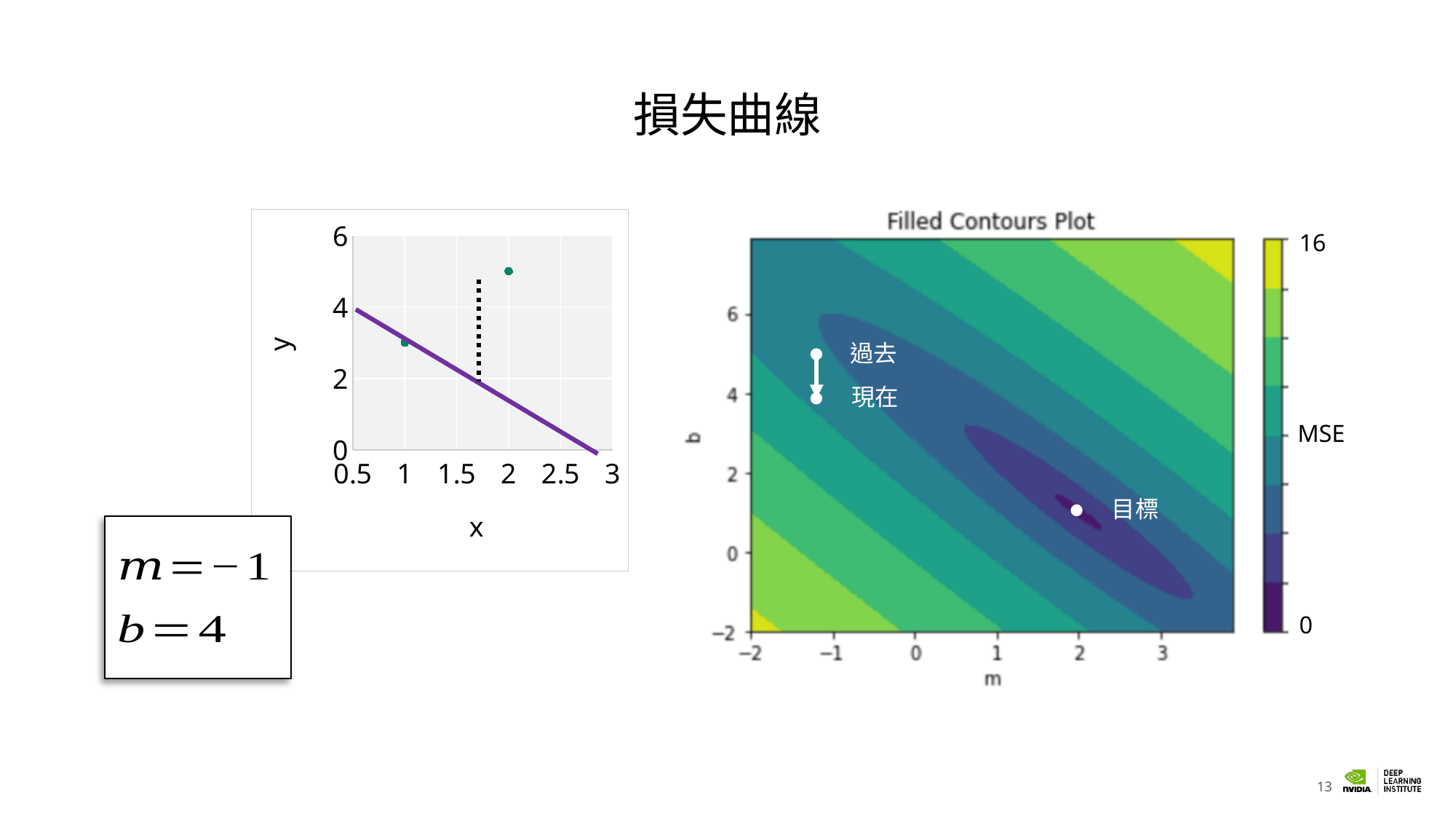
On the right chart, is the b value of the point labelled 過去 greater or less than 4? greater On the left chart, does the purple line rise or fall as x increases? fall On the right chart, what is the maximum value shown on the MSE colour bar? 16 On the right chart, is the m value of the point labelled 目標 greater or less than 1? greater On the left chart, which green point has the higher y value, the one at x = 1 or the one at x = 2? the one at x = 2 What kind of chart is the left chart with the x and y axes? scatter plot with a line On the left chart, what is the y value of the purple line at x = 0.5? 4 How many green data points are plotted on the left chart? 2 What is the title of the right chart? Filled Contours Plot On the left chart, is the y value of the green point at x = 2 greater or less than 4? greater On the right chart, what is the minimum value shown on the MSE colour bar? 0